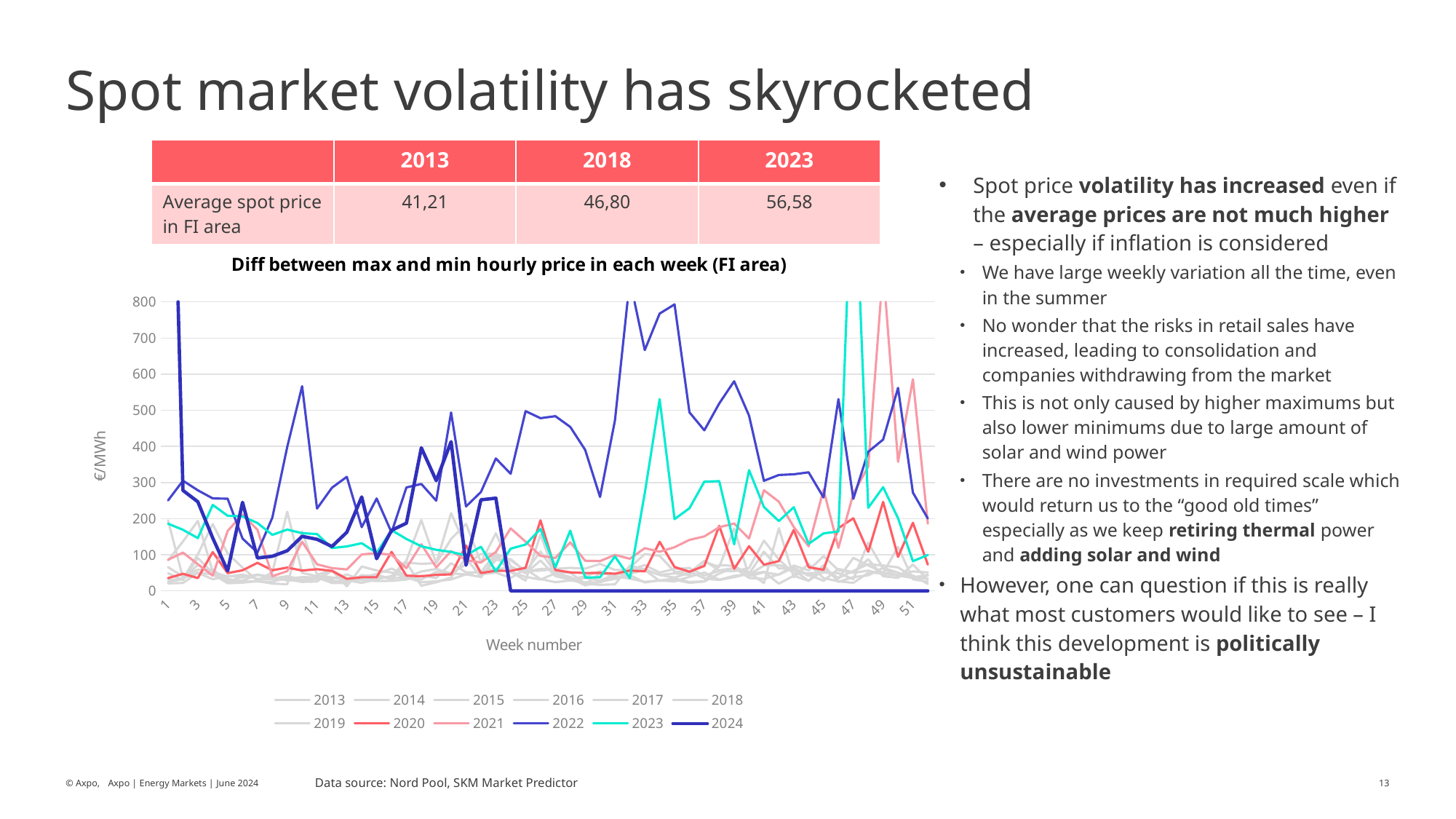
How many series does the chart legend list? 12 Is the value for 2021 at week 49 greater or less than 700? greater At week 1, which series has the larger value, 2024 or 2020? 2024 Is the value for 2022 at week 32 greater or less than 700? greater Is the value for 2023 at week 33 greater or less than 400? less What is the title of the chart? Diff between max and min hourly price in each week (FI area) What kind of chart is shown on the slide? line chart At week 33, which series has the larger value, 2023 or 2020? 2023 What unit is shown on the chart's y axis? €/MWh